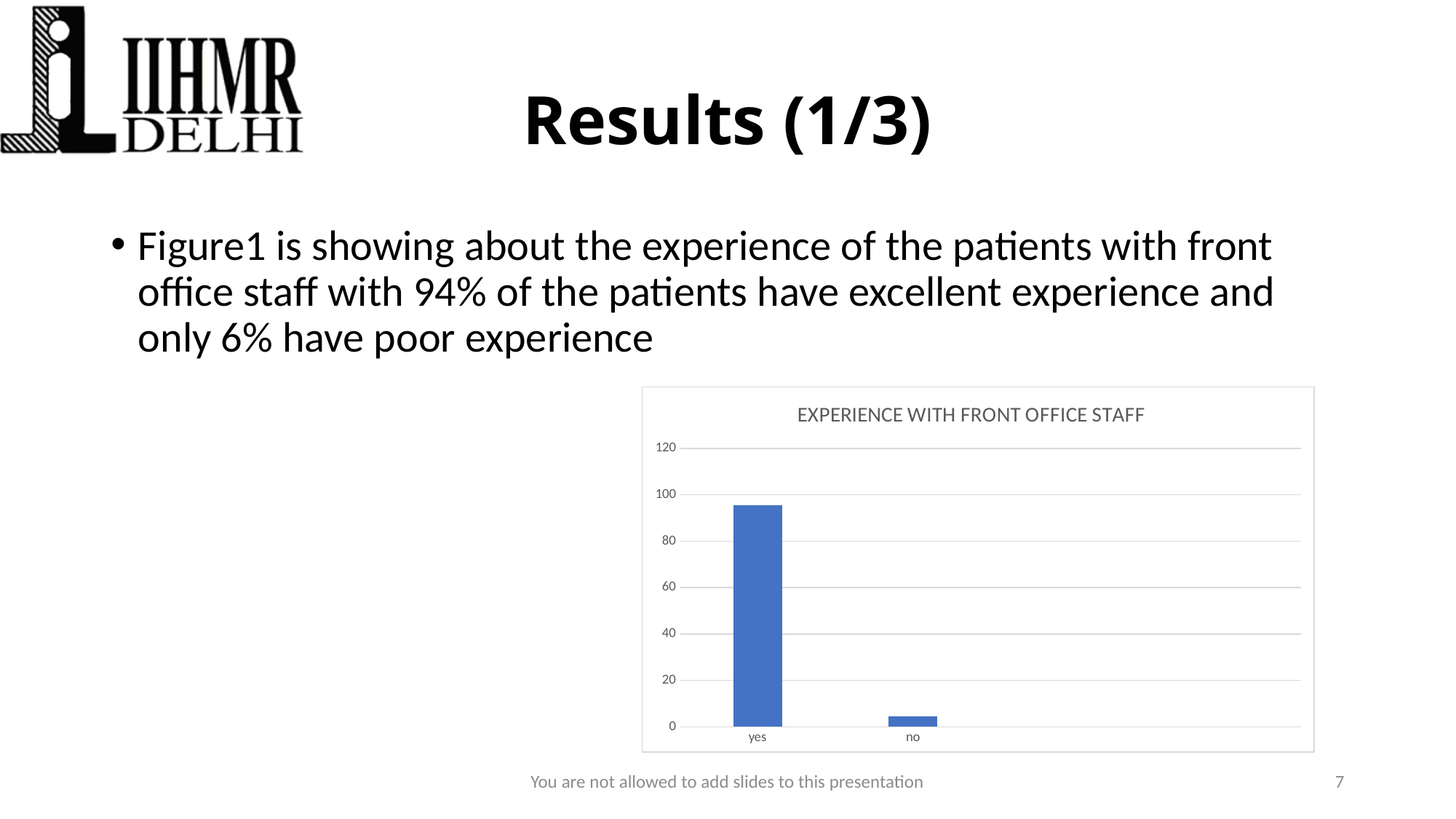
Which category has the lowest bar in the chart? no Which bar is taller, 'yes' or 'no'? yes What kind of chart is shown on the slide? bar chart Which category has the highest bar in the chart? yes Do the values fall or rise from 'yes' to 'no' along the x axis? fall Is the value for 'no' greater or less than 20? less Is the value for 'yes' greater or less than 80? greater Is the value for 'yes' greater or less than 100? less What is the maximum value shown on the y axis of the chart? 120 What is the title of the chart? EXPERIENCE WITH FRONT OFFICE STAFF How many categories are shown on the x axis of the chart? 2